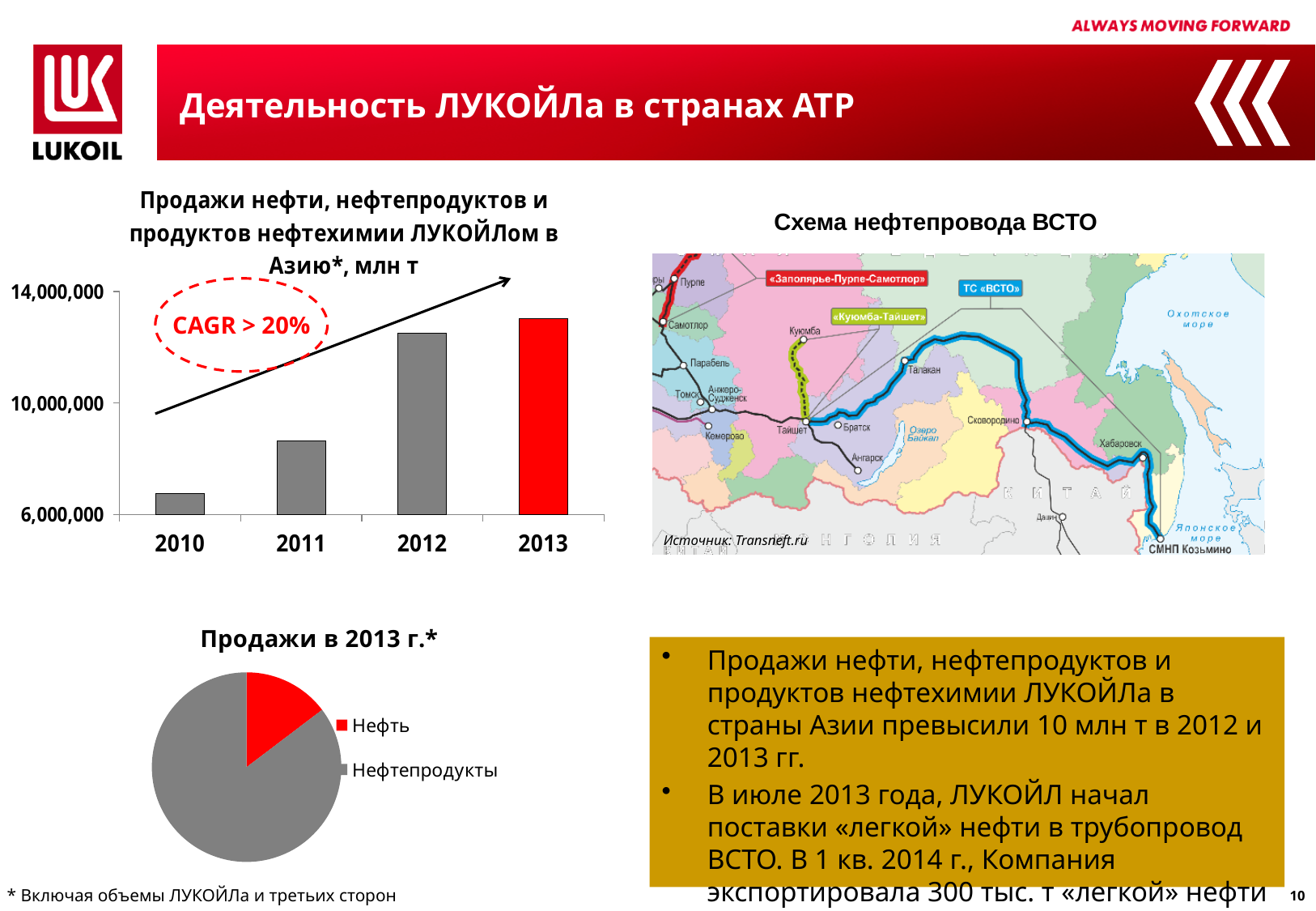
What growth rate is written in the dashed red oval on the bar chart of sales to Asia? CAGR > 20% What kind of chart is the chart titled "Продажи в 2013 г.*"? pie chart In the bar chart of sales to Asia, do the values rise or fall from 2010 to 2013? rise In the pie chart "Продажи в 2013 г.*", which slice is larger, Нефть or Нефтепродукты? Нефтепродукты What kind of chart is the chart titled "Продажи нефти, нефтепродуктов и продуктов нефтехимии ЛУКОЙЛом в Азию*, млн т"? bar chart In the bar chart of sales to Asia, is the value for 2012 greater or less than 10,000,000? greater In the bar chart of sales to Asia, which year has the lowest value? 2010 In the bar chart of sales to Asia, is the value for 2010 greater or less than 10,000,000? less In the bar chart of sales to Asia, is the value for 2011 greater or less than 10,000,000? less In the bar chart of sales to Asia, which year has the highest value? 2013 In the bar chart of sales to Asia, which is larger, the value for 2012 or the value for 2010? 2012 In the bar chart of sales to Asia, how many years are shown on the x axis? 4